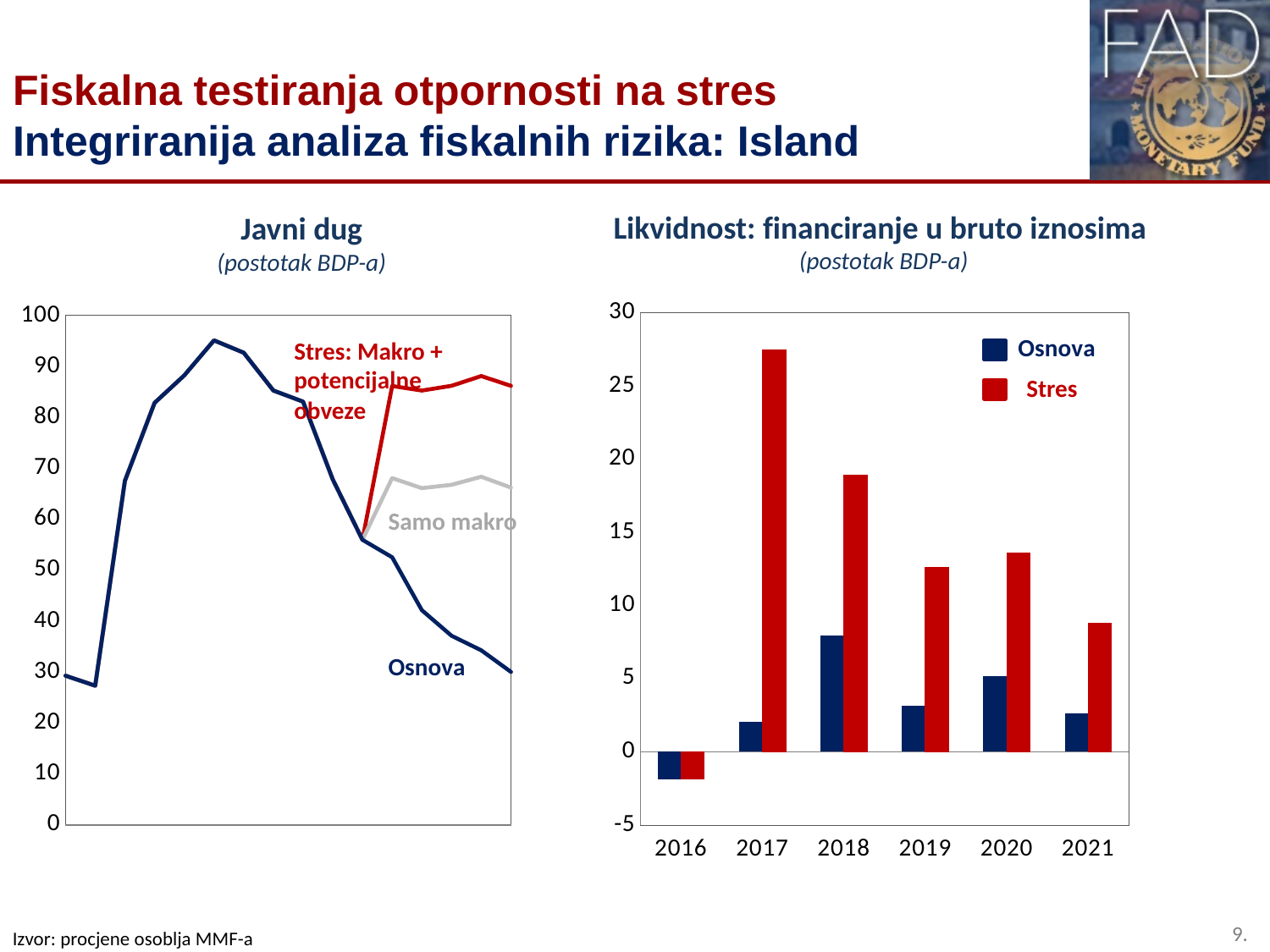
What kind of chart is the 'Javni dug' chart? line chart In the 'Likvidnost: financiranje u bruto iznosima' chart, which year has the lowest Osnova value? 2016 In the 'Likvidnost: financiranje u bruto iznosima' chart, is the Osnova value for 2018 greater or less than 10? less In the 'Likvidnost: financiranje u bruto iznosima' chart, which is larger in 2020: the Osnova value or the Stres value? Stres In the 'Likvidnost: financiranje u bruto iznosima' chart, is the Stres value for 2017 greater or less than 25? greater In the 'Javni dug' chart, what colour is the 'Stres: Makro + potencijalne obveze' line? red In the 'Likvidnost: financiranje u bruto iznosima' chart, how many years are shown on the x axis? 6 In the 'Javni dug' chart, is the peak of the Osnova line greater or less than 90? greater In the 'Likvidnost: financiranje u bruto iznosima' chart, which year has the highest Stres value? 2017 In the 'Likvidnost: financiranje u bruto iznosima' chart, how many series does the legend list? 2 What kind of chart is the 'Likvidnost: financiranje u bruto iznosima' chart? bar chart In the 'Likvidnost: financiranje u bruto iznosima' chart, which year has the highest Osnova value? 2018